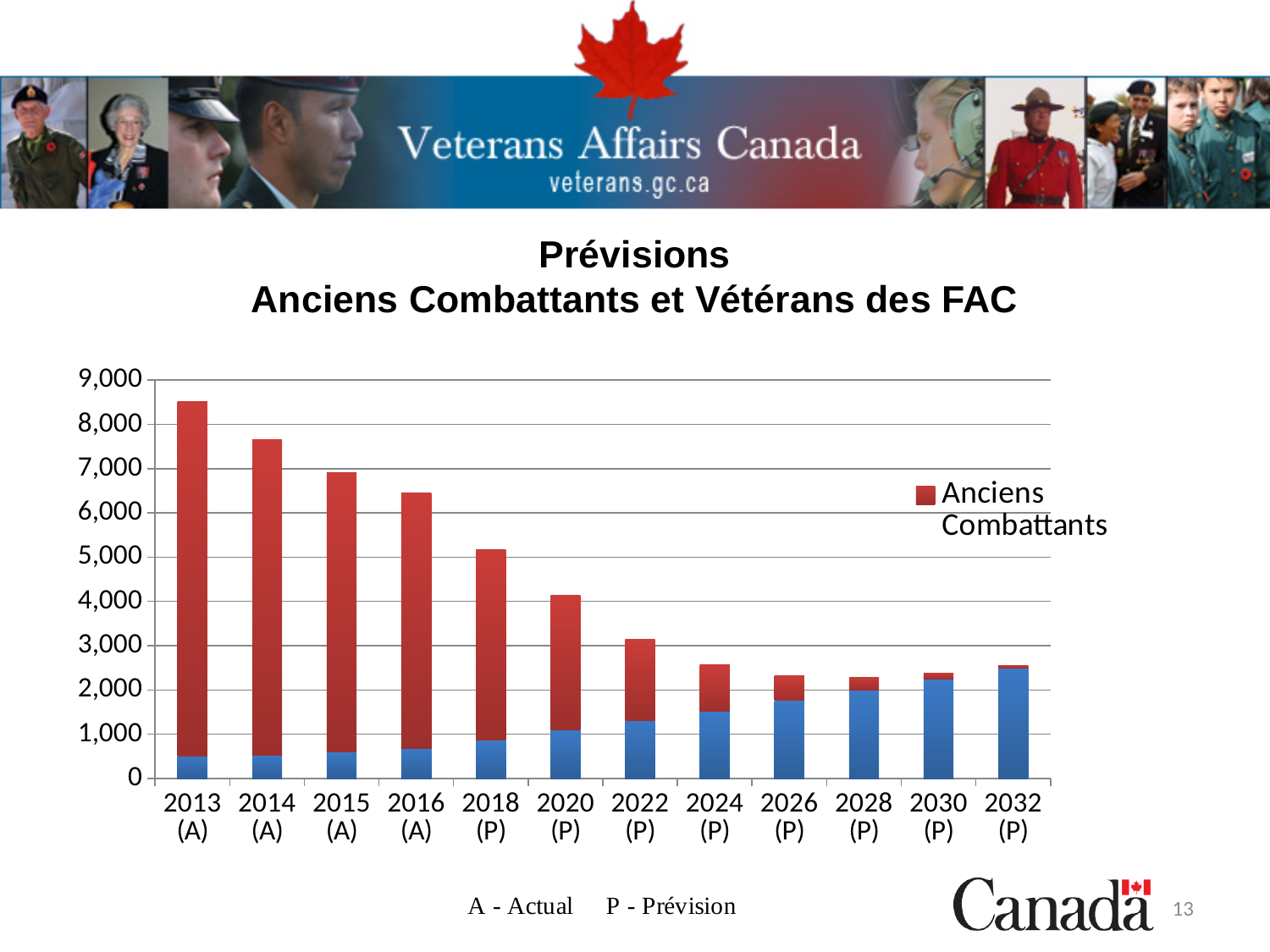
Is the blue segment for 2013 (A) greater or less than 1,000? less What kind of chart is shown on the slide? Stacked bar chart According to the note below the chart, what does the letter P stand for? Prévision Does the red Anciens Combattants segment rise or fall from 2013 (A) to 2032 (P)? fall Which series is named in the chart legend? Anciens Combattants Is the total bar for 2013 (A) greater or less than 8,000? greater Is the total bar for 2018 (P) greater or less than 5,000? greater Which is larger, the total bar for 2013 (A) or the total bar for 2032 (P)? 2013 (A) Which year has the tallest total bar? 2013 (A) How many year categories are shown on the x axis? 12